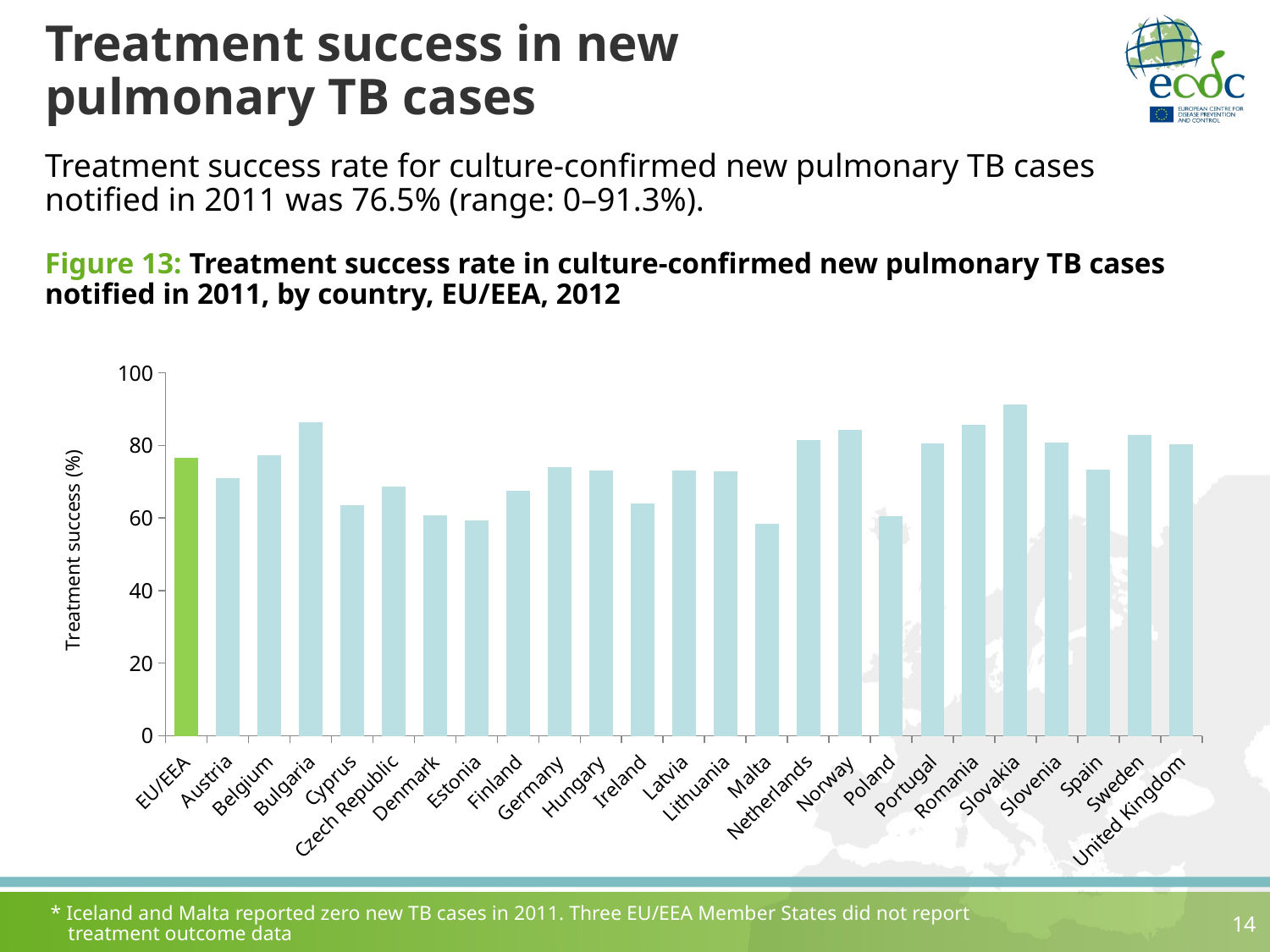
How many bars (countries plus EU/EEA) are plotted in the chart? 25 Is the treatment success rate for Romania greater or less than 80? greater What is the label on the vertical axis of the chart? Treatment success (%) What kind of chart is shown on the slide? bar chart Is the treatment success rate for Denmark greater or less than 80? less Which has a higher treatment success rate, Bulgaria or Cyprus? Bulgaria What is the treatment success rate for EU/EEA shown on the slide? 76.5% Which country has the highest treatment success rate in the chart? Slovakia Which bar in the chart is coloured green rather than light blue? EU/EEA Is the treatment success rate for Bulgaria greater or less than 80? greater Which has a higher treatment success rate, Sweden or Denmark? Sweden